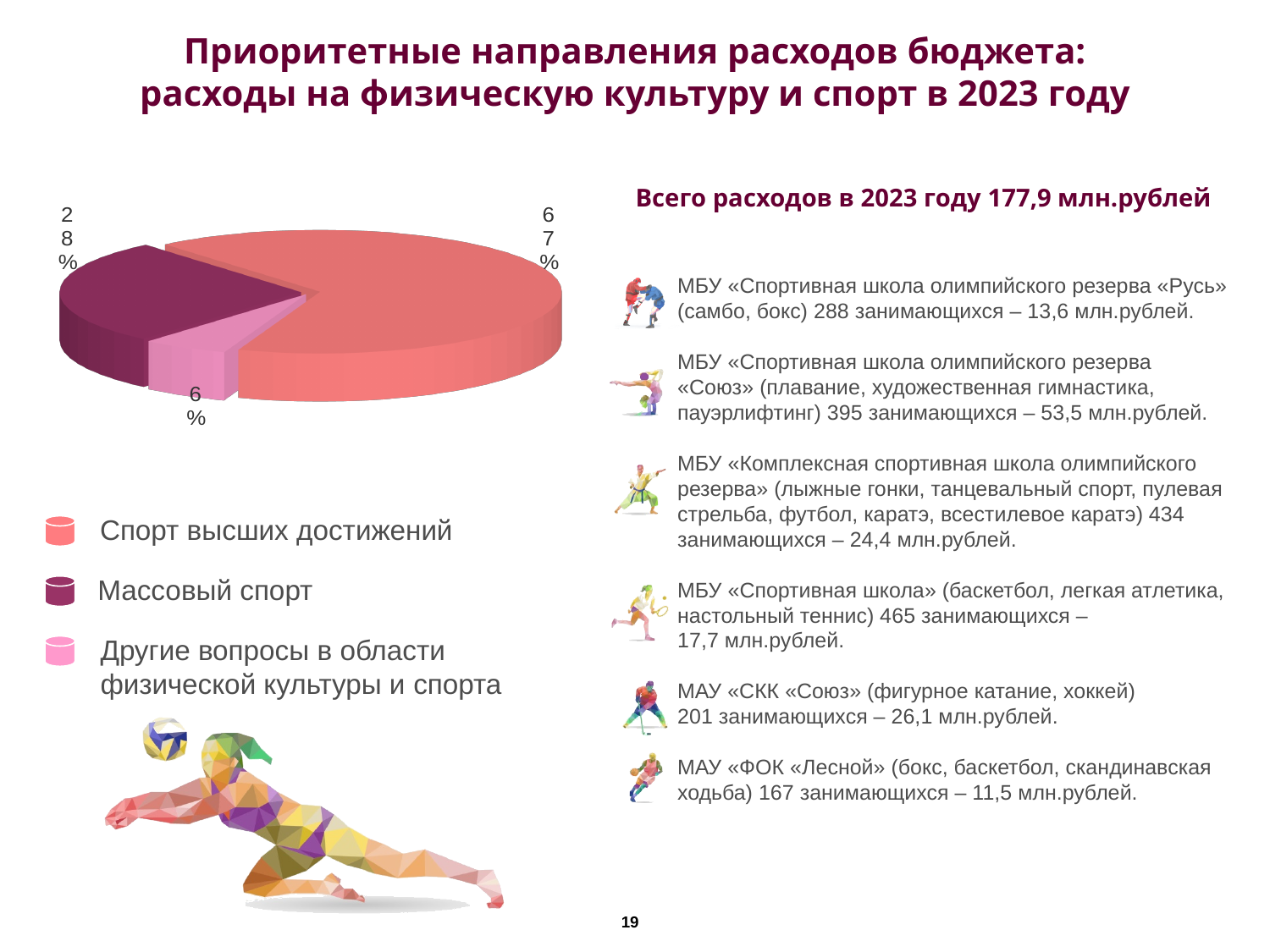
How many slices does the pie chart have? 3 How many entries does the legend of the pie chart list? 3 What share of the pie does «Другие вопросы в области физической культуры и спорта» take? 6% What is the difference in percentage points between the «Массовый спорт» slice and the «Другие вопросы в области физической культуры и спорта» slice? 22 Which legend entry is shown in the darkest (magenta) colour? Массовый спорт What share of the pie does «Спорт высших достижений» take? 67% Which is larger: the share for «Массовый спорт» or the share for «Другие вопросы в области физической культуры и спорта»? Массовый спорт What kind of chart is shown on the slide? pie chart Which category has the largest slice of the pie? Спорт высших достижений Which category has the smallest slice of the pie? Другие вопросы в области физической культуры и спорта What is the difference in percentage points between the «Спорт высших достижений» slice and the «Массовый спорт» slice? 39 What share of the pie does «Массовый спорт» take? 28%